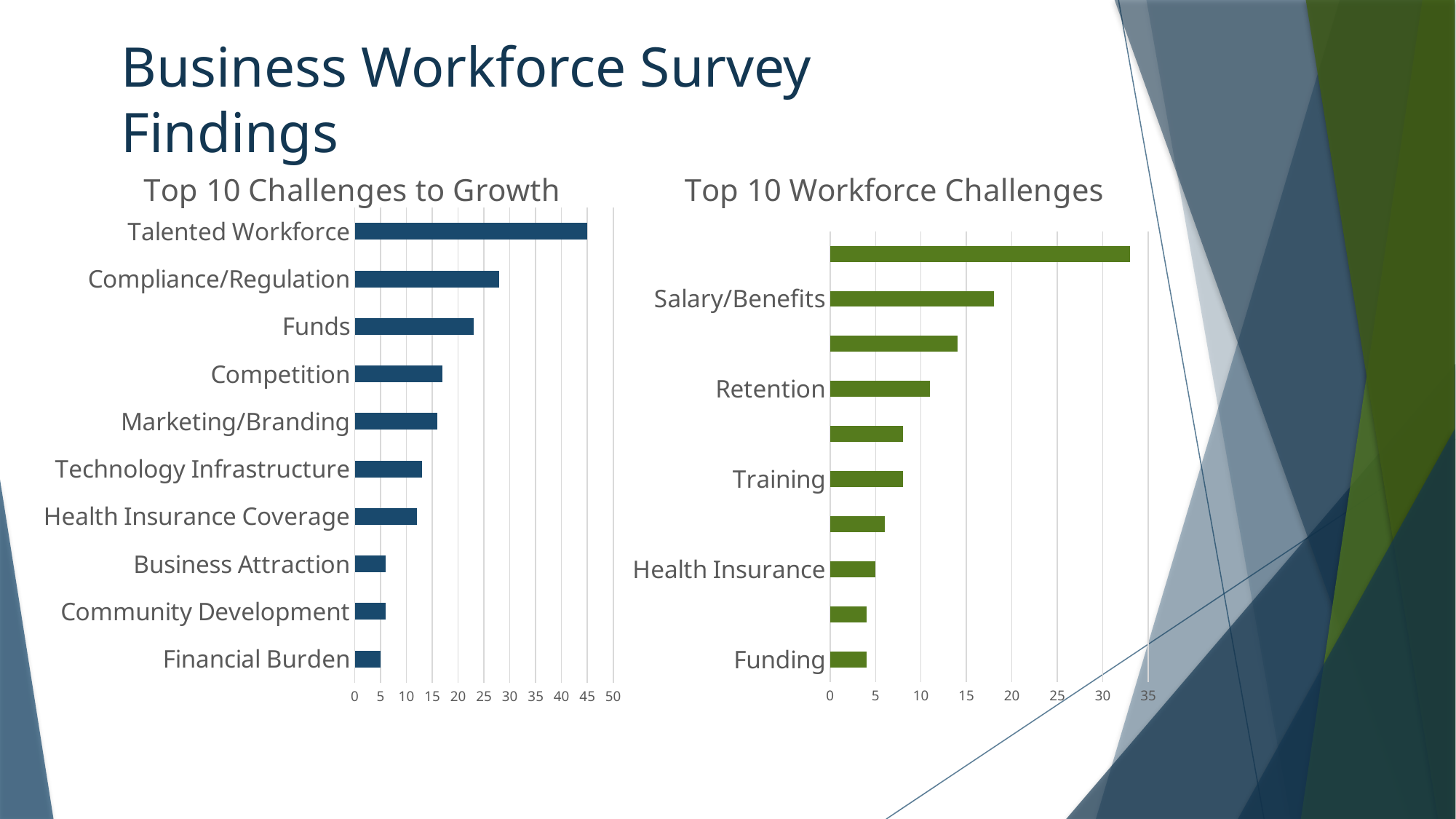
In the 'Top 10 Workforce Challenges' chart, which is larger, Salary/Benefits or Retention? Salary/Benefits In the 'Top 10 Workforce Challenges' chart, how many bars are plotted? 10 What kind of chart is the 'Top 10 Challenges to Growth' chart? Bar chart In the 'Top 10 Challenges to Growth' chart, is the value for Talented Workforce greater or less than 40? greater What colour are the bars in the 'Top 10 Workforce Challenges' chart? Green In the 'Top 10 Challenges to Growth' chart, how many categories are plotted? 10 In the 'Top 10 Challenges to Growth' chart, which is larger, Compliance/Regulation or Funds? Compliance/Regulation In the 'Top 10 Challenges to Growth' chart, is the value for Funds greater or less than 25? less In the 'Top 10 Challenges to Growth' chart, which category has the highest value? Talented Workforce In the 'Top 10 Challenges to Growth' chart, is the value for Health Insurance Coverage greater or less than 15? less